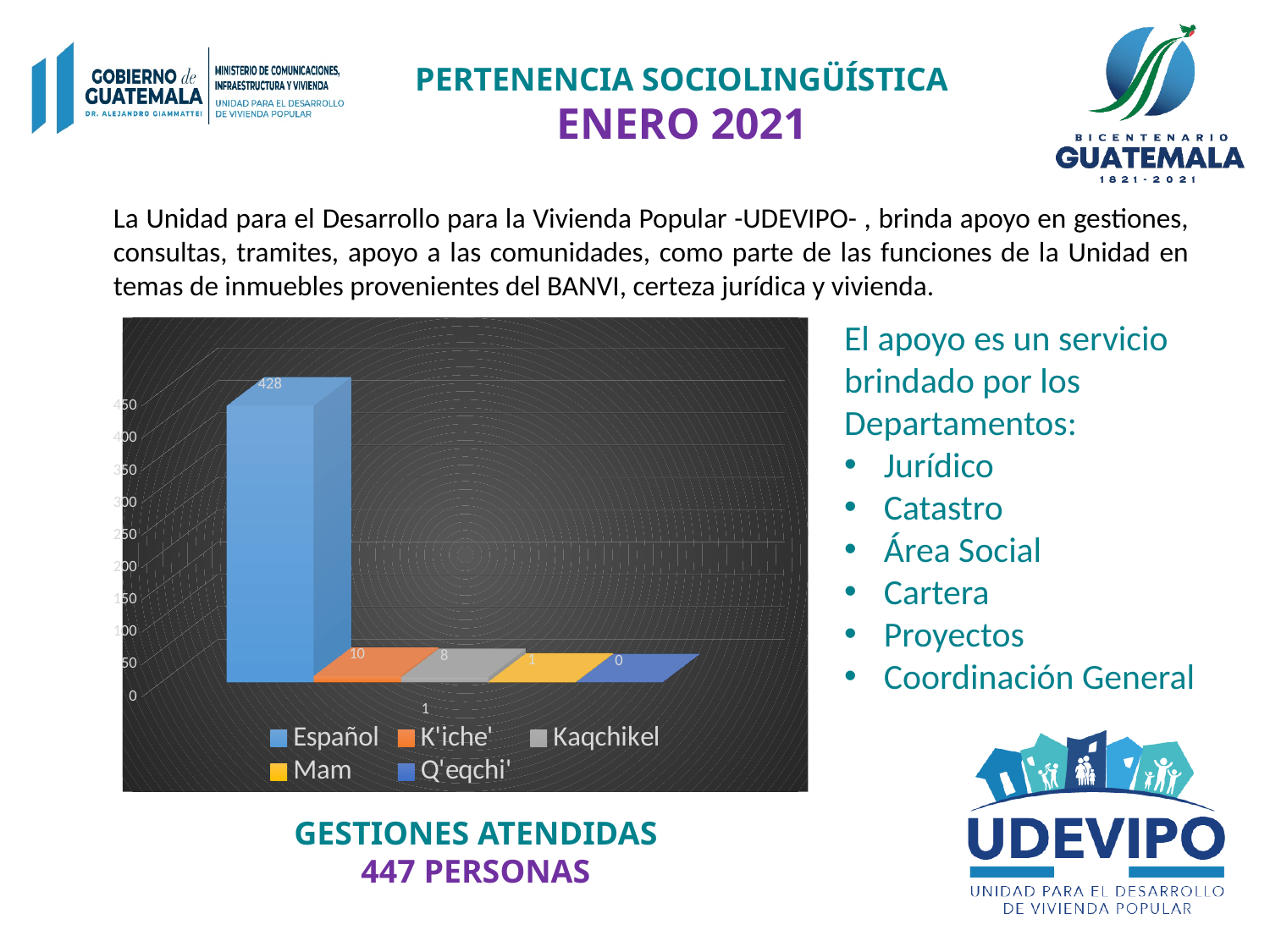
How many series does the legend list? 5 What kind of chart is shown on the slide? Bar chart What is the difference between the values for Español and K'iche'? 418 What is the value for Español? 428 Which language has the lowest value? Q'eqchi' What is the value for Mam? 1 Is the value for Español greater or less than 400? greater What is the value for Q'eqchi'? 0 What is the value for Kaqchikel? 8 Which language has the highest value? Español What is the value for K'iche'? 10 Which is larger, the value for K'iche' or the value for Kaqchikel? K'iche'